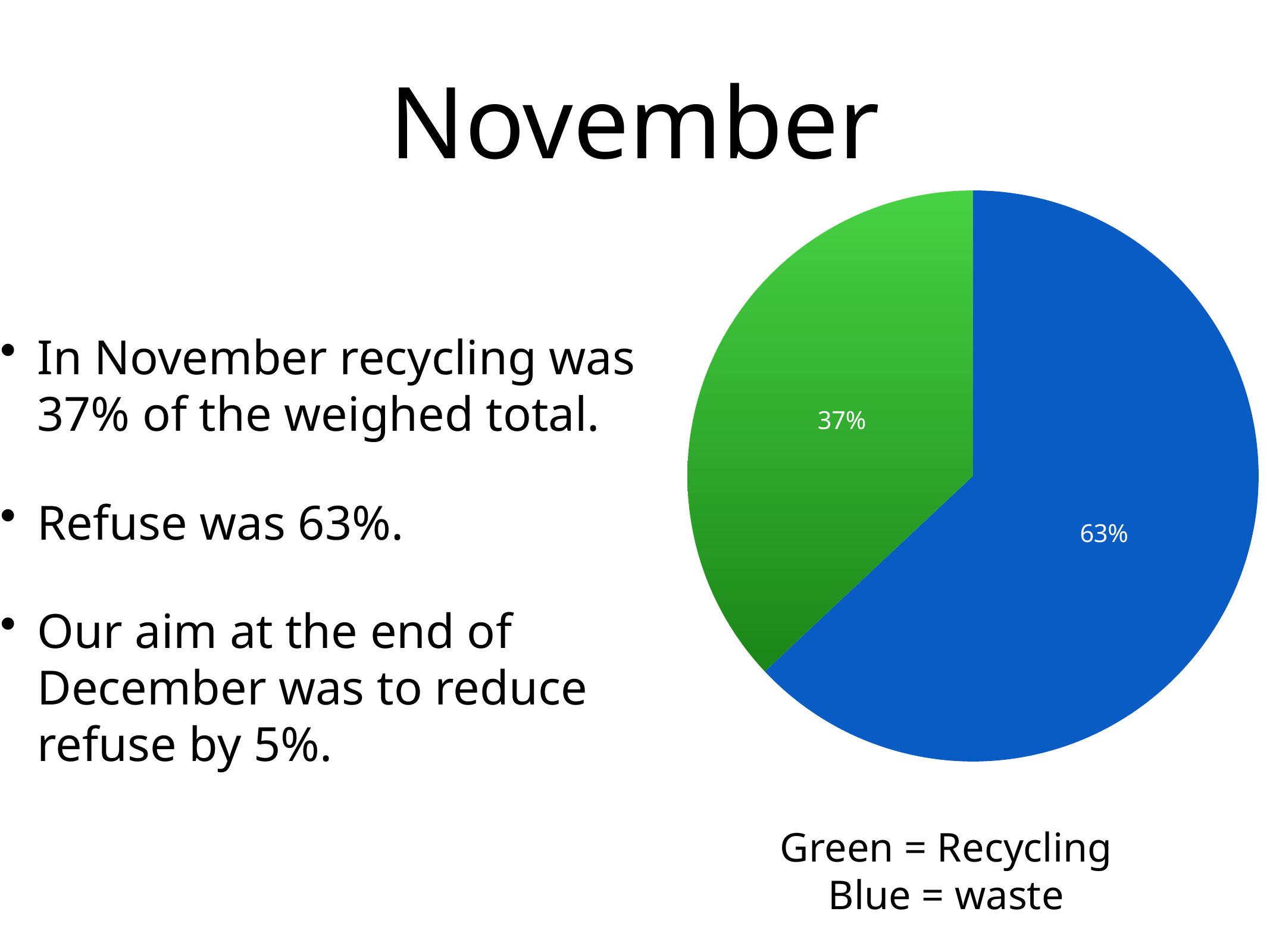
Which slice of the pie is the smallest? Green (Recycling) What share of the pie does the green (Recycling) slice represent? 37% How many slices does the pie chart have? 2 What kind of chart is shown on the slide? pie chart What share of the pie does the blue (waste) slice represent? 63% What colour represents Recycling in the pie chart? Green Is the Recycling slice greater or less than 50% of the pie? less What is the difference in percentage points between the waste slice and the Recycling slice? 26 Which slice of the pie is the largest? Blue (waste) Which is larger, the Recycling slice or the waste slice? waste What does the blue colour represent in the pie chart? waste